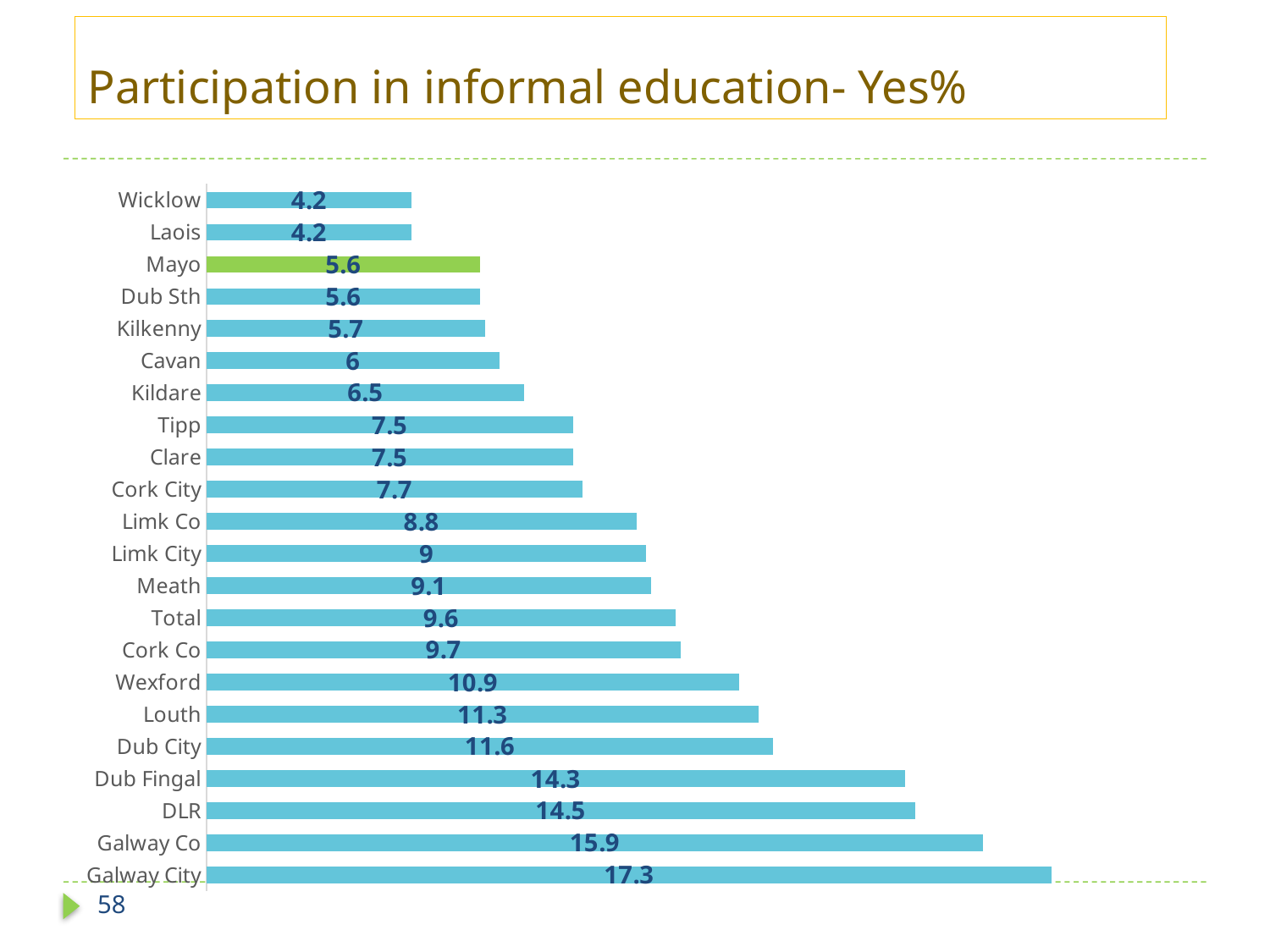
What is the value for Mayo? 5.6 What is the value for Cork City? 7.7 What is the difference between the values for Galway City and Mayo? 11.7 Which has a larger value, Louth or Wexford? Louth Which category has the highest value? Galway City What is the value for Total? 9.6 Which category's bar is coloured green instead of blue? Mayo What kind of chart is shown on the slide? Bar chart What is the difference between the values for DLR and Dub Fingal? 0.2 How many categories are shown in the chart? 22 Do the values increase or decrease going down the chart from Wicklow to Galway City? Increase What is the value for Galway Co? 15.9